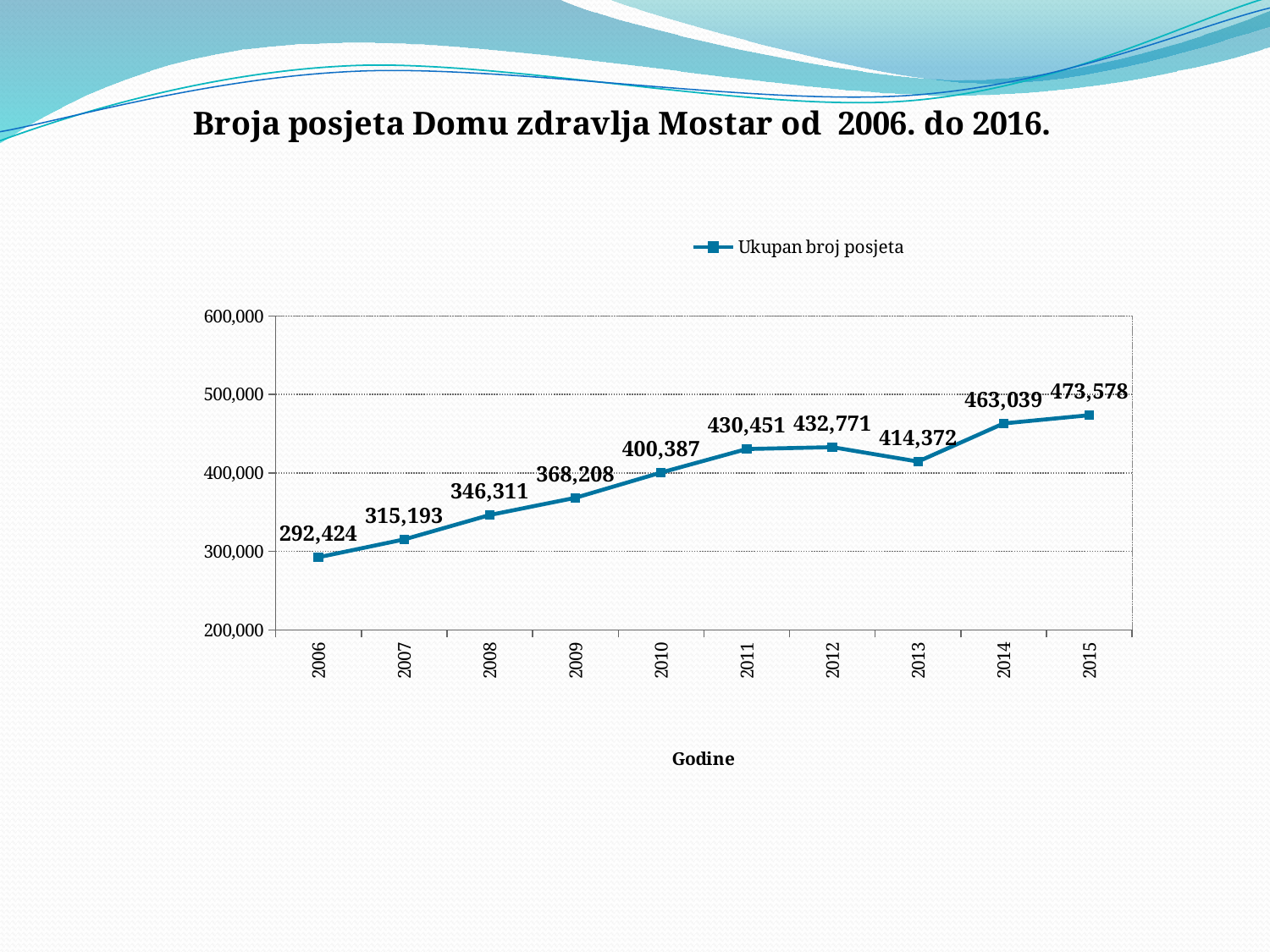
Which year has the highest number of visits? 2015 What is the value for 2010? 400,387 Which is larger, the value for 2012 or the value for 2013? 2012 What is the difference between the values for 2015 and 2006? 181,154 Which year has the lowest number of visits? 2006 What is the difference between the values for 2014 and 2013? 48,667 What is the name of the series shown in the legend? Ukupan broj posjeta How many years are plotted on the x axis? 10 What is the value for 2013? 414,372 What type of chart is shown on the slide? line chart Is the value for 2009 greater or less than 400,000? less What is the value for 2006? 292,424